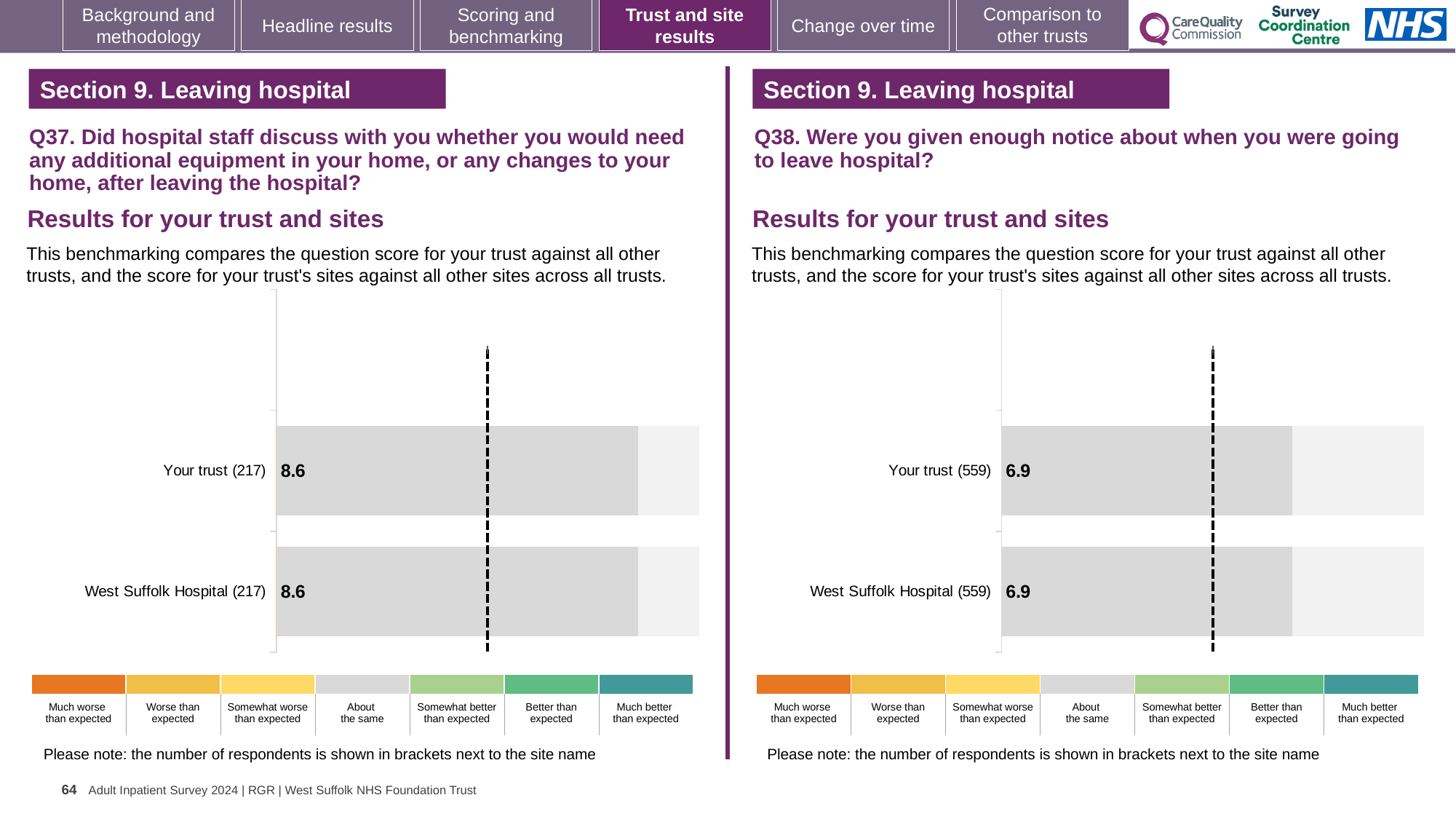
In the Q38 chart on the right, what is the score for West Suffolk Hospital? 6.9 What kind of chart is the Q37 chart on the left? Bar chart In the Q38 chart on the right, what is the score for Your trust? 6.9 In the Q37 chart on the left, which colour in the key represents 'Much worse than expected'? Orange In the Q37 chart on the left, what is the score for West Suffolk Hospital? 8.6 In the Q38 chart on the right, how many respondents are shown in brackets for Your trust? 559 Is the score for Your trust in the Q37 chart on the left larger or smaller than the score for Your trust in the Q38 chart on the right? Larger In the Q37 chart on the left, how many respondents are shown in brackets for West Suffolk Hospital? 217 In the Q38 chart on the right, how many bars are plotted? 2 In the Q37 chart on the left, what is the score for Your trust? 8.6 In the Q37 chart on the left, what is the difference between the score for Your trust and the score for West Suffolk Hospital? 0 In the Q38 chart on the right, how many categories does the colour key below the chart list? 7